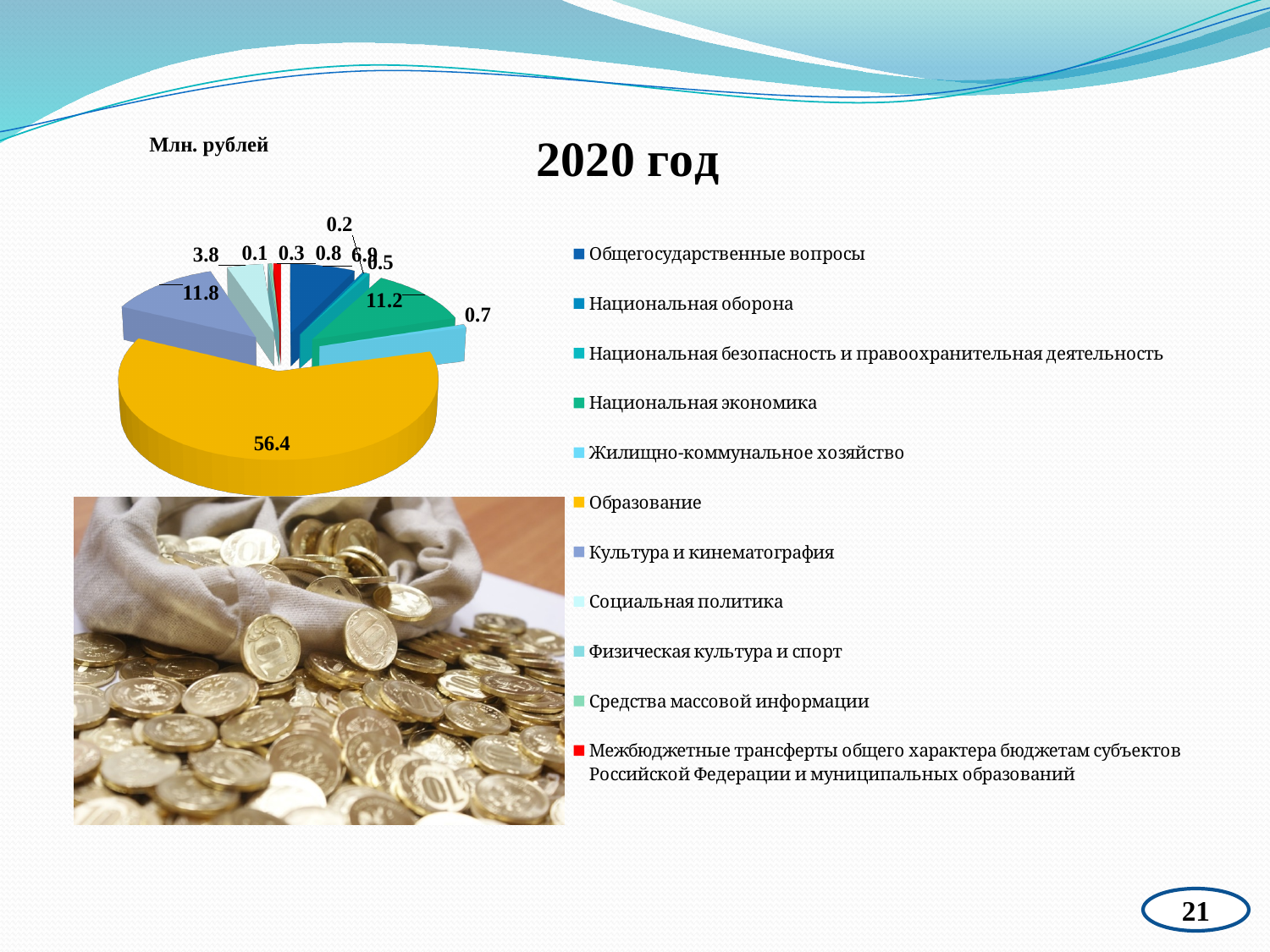
What is the difference between the values for Образование and Культура и кинематография? 44.6 What is the smallest value labelled on the pie chart? 0.1 What is the value for Жилищно-коммунальное хозяйство in the pie chart? 0.7 Which category has the largest slice in the pie chart? Образование What year is given in the title above the chart? 2020 год Which is larger, the value for Национальная экономика or the value for Жилищно-коммунальное хозяйство? Национальная экономика What is the value for Национальная экономика in the pie chart? 11.2 How many categories does the legend of the pie chart list? 11 What kind of chart is shown on the slide? pie chart What is the value for Культура и кинематография in the pie chart? 11.8 What unit is stated for the values in the pie chart? Млн. рублей What is the value for Образование in the pie chart? 56.4